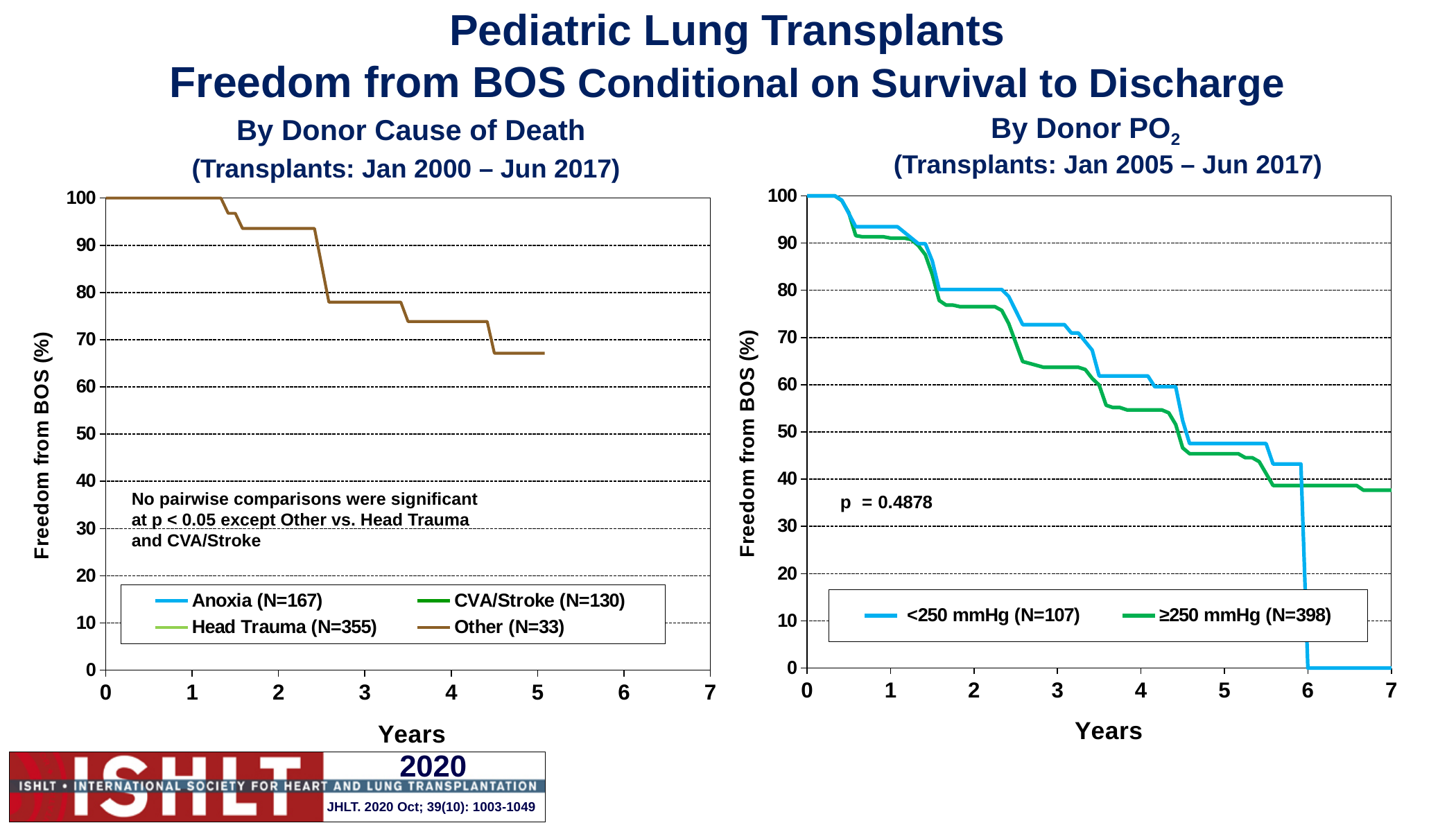
In the 'By Donor PO2' chart, what is the freedom from BOS for <250 mmHg (N=107) at year 7? 0 In the 'By Donor PO2' chart, which series has the higher freedom from BOS at year 4, <250 mmHg or ≥250 mmHg? <250 mmHg In the 'By Donor PO2' chart, is the value for ≥250 mmHg (N=398) at year 7 greater or less than 30? greater In the 'By Donor Cause of Death' chart, is the value for Other (N=33) at year 5 greater or less than 60? greater In the 'By Donor Cause of Death' chart, what is the N for Head Trauma in the legend? N=355 What kind of chart is the 'By Donor Cause of Death' chart on the left? line chart In the 'By Donor PO2' chart, do the freedom from BOS values rise or fall as years increase? fall What p-value is shown on the 'By Donor PO2' chart? p = 0.4878 In the 'By Donor Cause of Death' chart, what is the freedom from BOS for Other (N=33) at year 0? 100 How many series does the legend of the 'By Donor Cause of Death' chart list? 4 In the 'By Donor Cause of Death' chart, is the value for Other (N=33) at year 3 greater or less than 70? greater How many series does the legend of the 'By Donor PO2' chart list? 2